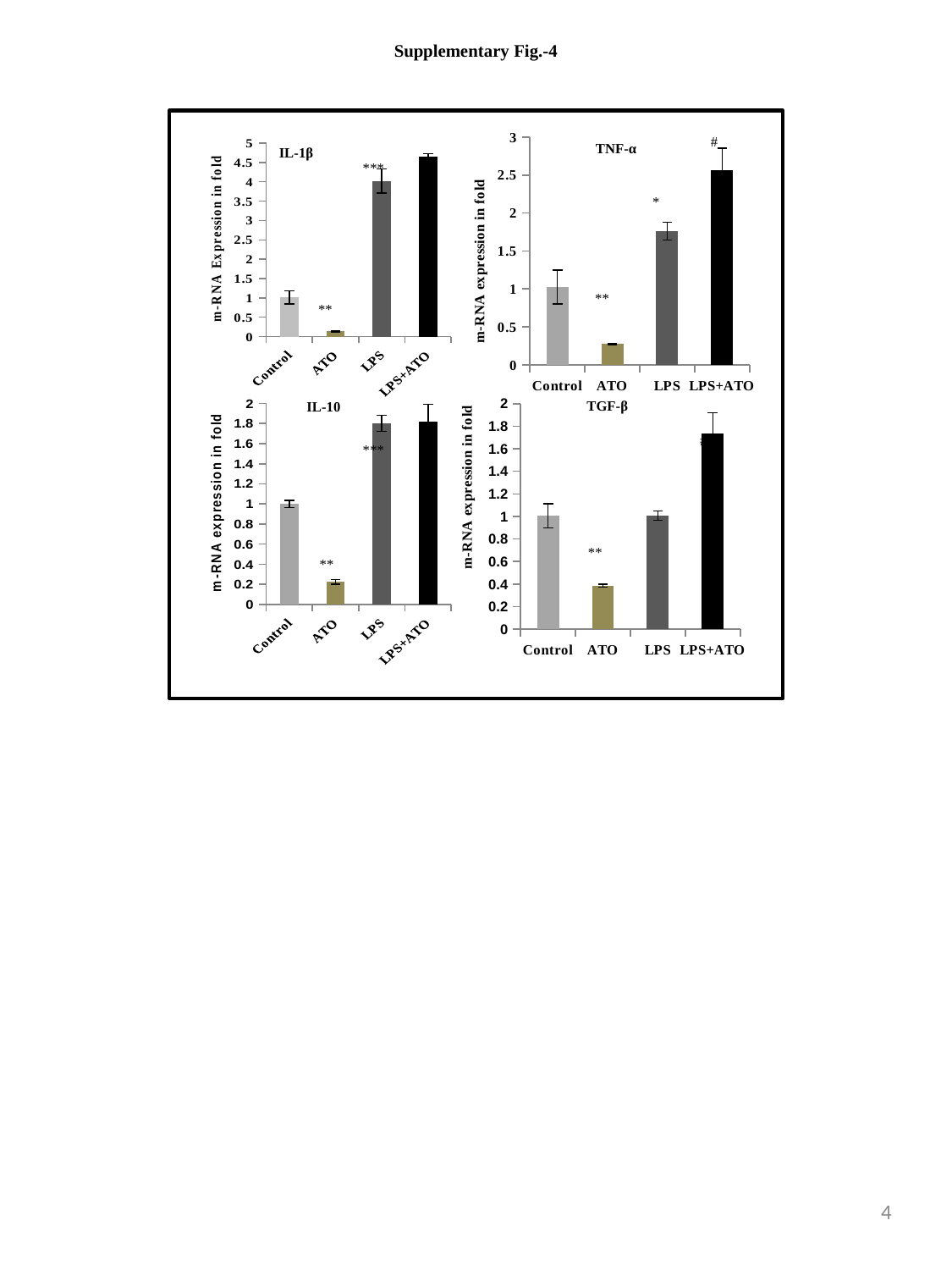
In the IL-10 chart, is the value for ATO greater or less than 0.4? less What is the y-axis label of the TGF-β chart? m-RNA expression in fold In the IL-1β chart, which category has the highest bar? LPS+ATO In the TNF-α chart, which category has the highest bar? LPS+ATO In the TGF-β chart, which category has the highest bar? LPS+ATO In the TNF-α chart, which is larger, the value for Control or the value for ATO? Control In the IL-1β chart, what kind of chart is shown? bar chart In the TNF-α chart, is the value for LPS greater or less than 1.5? greater In the IL-10 chart, which category has the lowest bar? ATO In the IL-1β chart, which category has the lowest bar? ATO In the IL-1β chart, is the value for LPS greater or less than 3? greater In the IL-1β chart, how many categories are shown on the x axis? 4